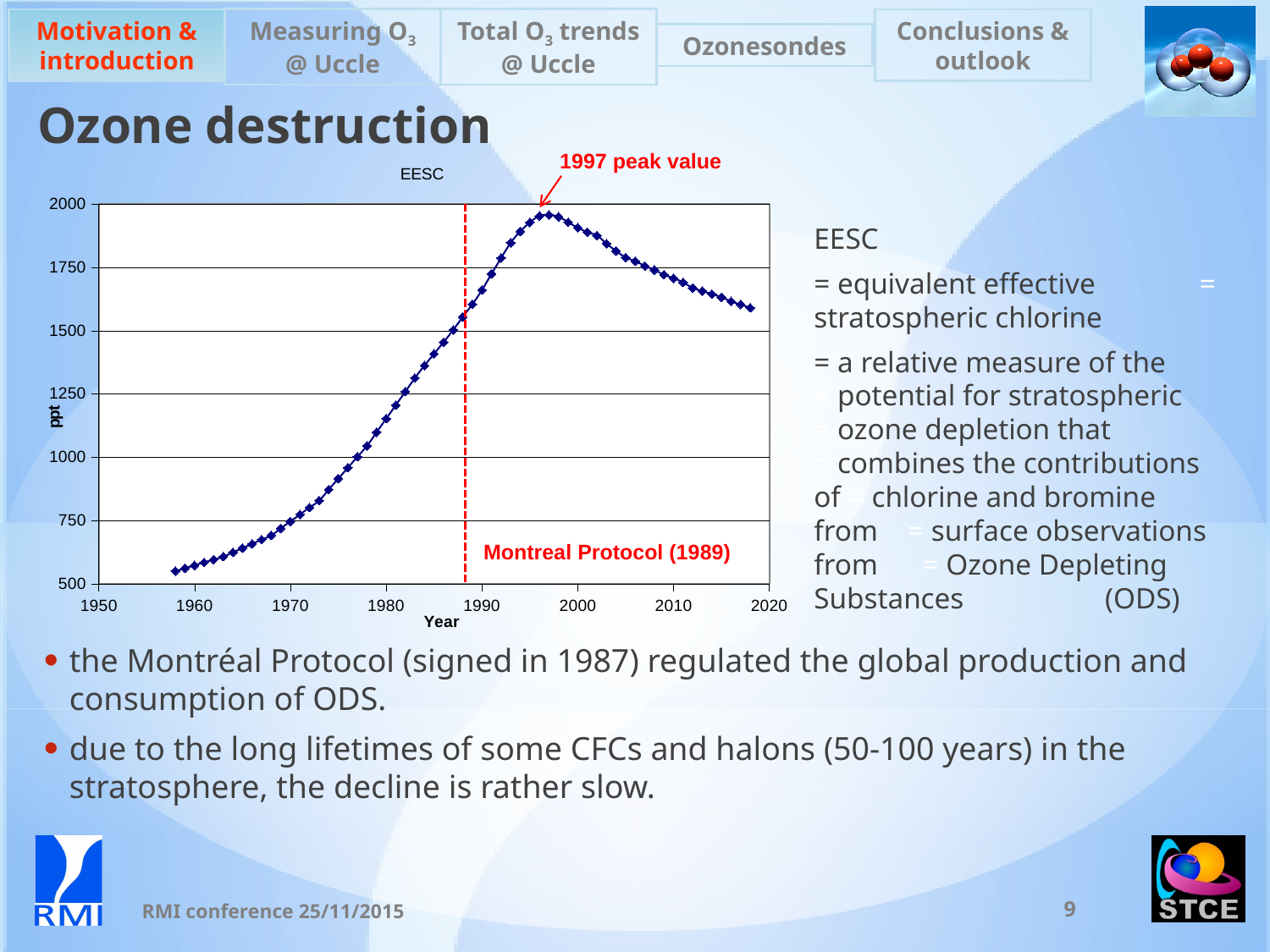
Which year has the higher EESC value, 1980 or 2010? 2010 Is the EESC value for 1970 greater or less than 1000? less Does the EESC series rise or fall between 2000 and 2020? fall Is the EESC value for 2010 greater or less than 1500? greater What kind of chart is shown on the slide? line chart Is the EESC value for 1997 greater or less than 1750? greater What is the label of the y-axis of the chart? ppt What is the title of the chart? EESC Does the EESC series rise or fall between 1960 and 1990? rise In which year does the EESC series reach its peak value? 1997